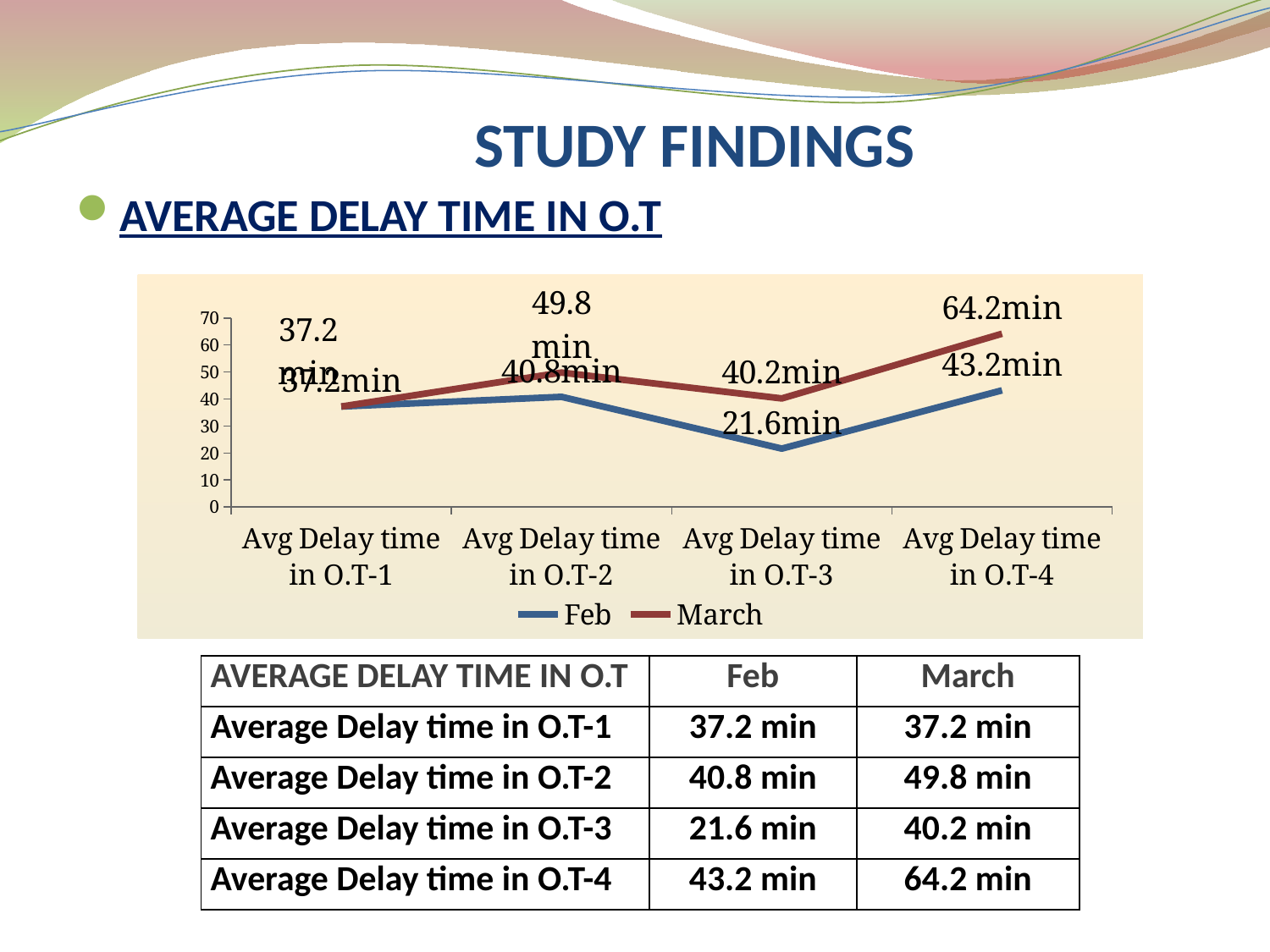
What is the difference between the March and Feb values for Avg Delay time in O.T-4? 21 min How many categories are plotted along the x axis of the chart? 4 What is the March value for Avg Delay time in O.T-4? 64.2 min Does the Feb series rise or fall from Avg Delay time in O.T-3 to Avg Delay time in O.T-4? rise Which category has the lowest Feb value? Avg Delay time in O.T-3 For Avg Delay time in O.T-2, which series has the larger value, Feb or March? March Which category has the highest March value? Avg Delay time in O.T-4 How many series does the chart's legend list? 2 What kind of chart is shown on the slide? line chart Is the Feb value for Avg Delay time in O.T-3 greater or less than 30? less What is the Feb value for Avg Delay time in O.T-3? 21.6 min What is the March value for Avg Delay time in O.T-2? 49.8 min